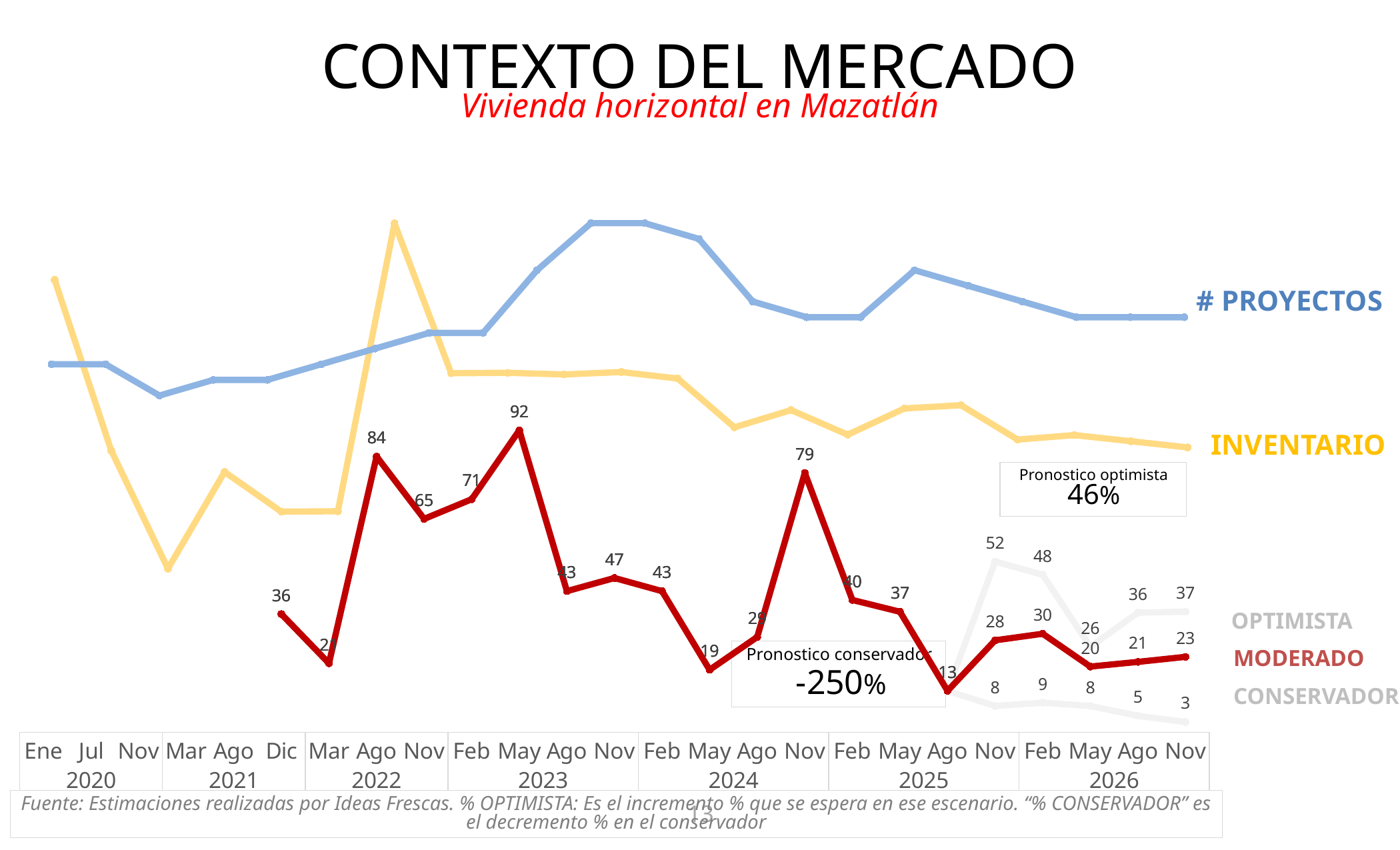
What is the lowest value labelled on the MODERADO line? 13 What percentage is given for the 'Pronostico optimista'? 46% How many labelled points does the OPTIMISTA line have? 5 What type of chart is shown on the slide? line chart What is the value of the MODERADO line at Nov 2024? 79 What is the highest value labelled on the OPTIMISTA line? 52 What is the difference between the OPTIMISTA and CONSERVADOR values at Nov 2026 (37 and 3)? 34 Do the CONSERVADOR values rise or fall from Nov 2025 to Nov 2026? fall What is the last value labelled on the CONSERVADOR line, at Nov 2026? 3 Which is larger on the MODERADO line: the peak labelled 84 in 2022 or the peak labelled 79 in 2024? 84 How many series are labelled on the right side of the chart? 5 What is the highest value labelled on the MODERADO line? 92